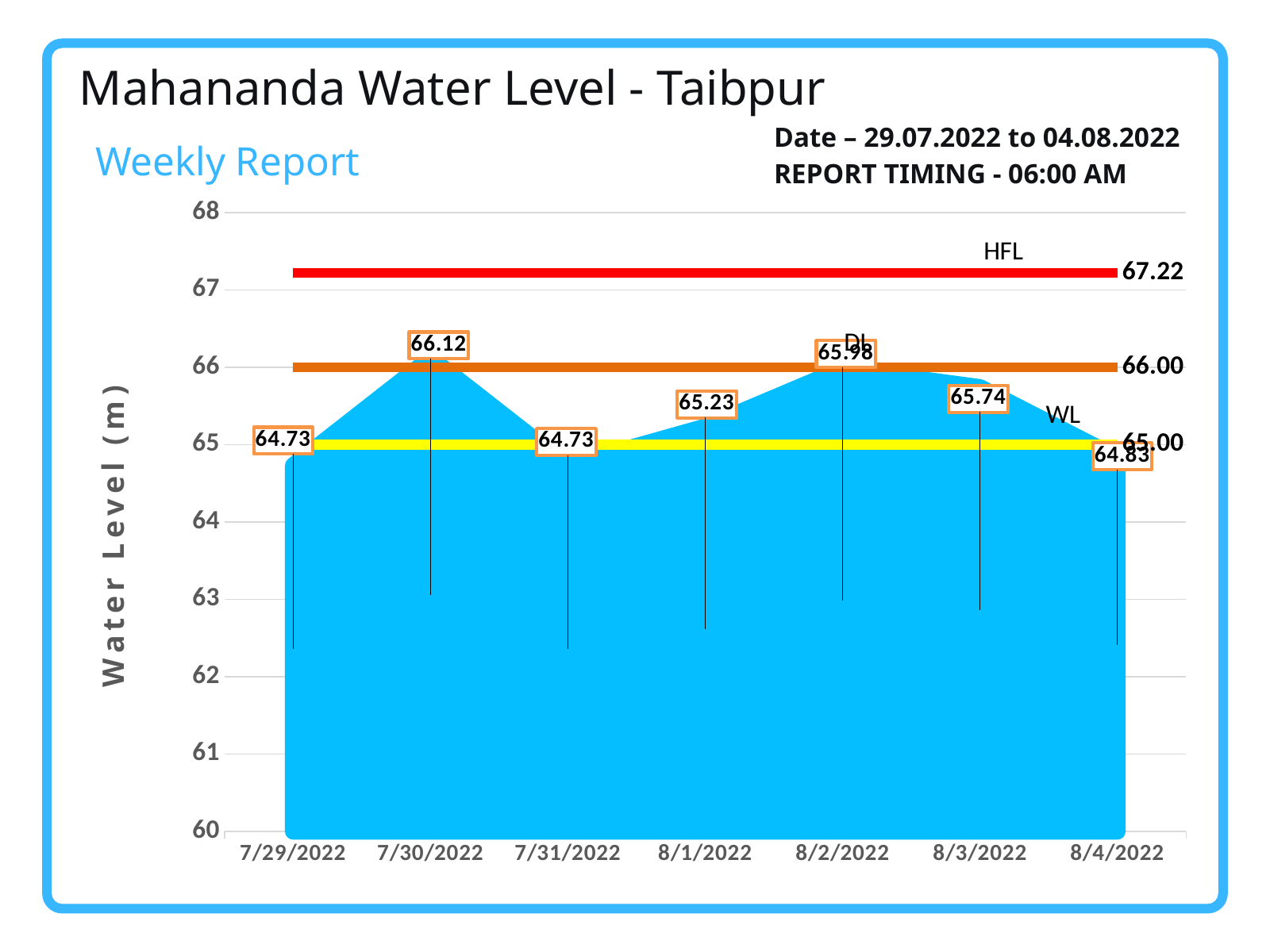
Which date had a higher water level, 8/1/2022 or 8/3/2022? 8/3/2022 What value is shown for the DL line? 66.00 Did the water level rise or fall from 8/2/2022 to 8/4/2022? fall What was the water level on 7/30/2022? 66.12 What value is shown for the HFL line? 67.22 What was the water level on 8/2/2022? 65.98 Is the water level on 8/2/2022 greater or less than 65? greater What is the lowest water level value shown on the chart? 64.73 What was the water level on 8/4/2022? 64.83 What is the difference between the water level on 7/30/2022 and on 7/31/2022? 1.39 How many dates are plotted on the x axis? 7 On which date was the water level highest? 7/30/2022